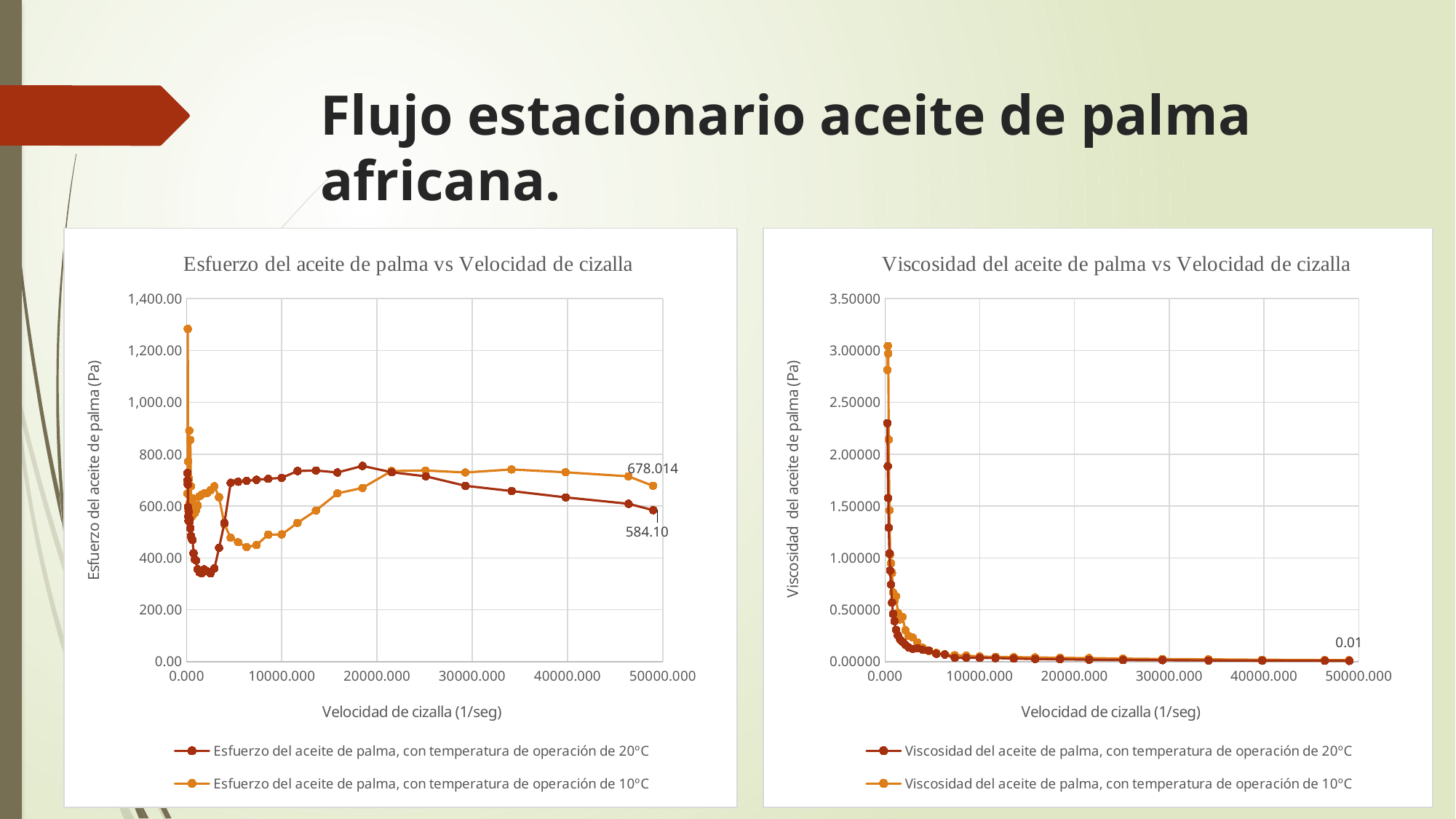
In the left chart, what is the labelled value of the 10°C series at the right end of the x axis? 678.014 In the left chart, at the right end of the x axis, which series has the higher value: 20°C or 10°C? 10°C In the right chart, what value is labelled at the right end of the plotted lines? 0.01 What is the x-axis title of the left chart? Velocidad de cizalla (1/seg) In the left chart, what is the labelled value of the 20°C series at the right end of the x axis? 584.10 In the left chart, what is the difference between the labelled end values 678.014 and 584.10? 93.914 In the right chart, 'Viscosidad del aceite de palma vs Velocidad de cizalla', how many series does the legend list? 2 What kind of chart is the left chart, 'Esfuerzo del aceite de palma vs Velocidad de cizalla'? line chart In the left chart, 'Esfuerzo del aceite de palma vs Velocidad de cizalla', how many series does the legend list? 2 In the right chart, 'Viscosidad del aceite de palma vs Velocidad de cizalla', do the values rise or fall as the shear rate increases along the x axis? fall In the right chart, is the value of the 20°C series at 50000.000 greater or less than 0.50000? less